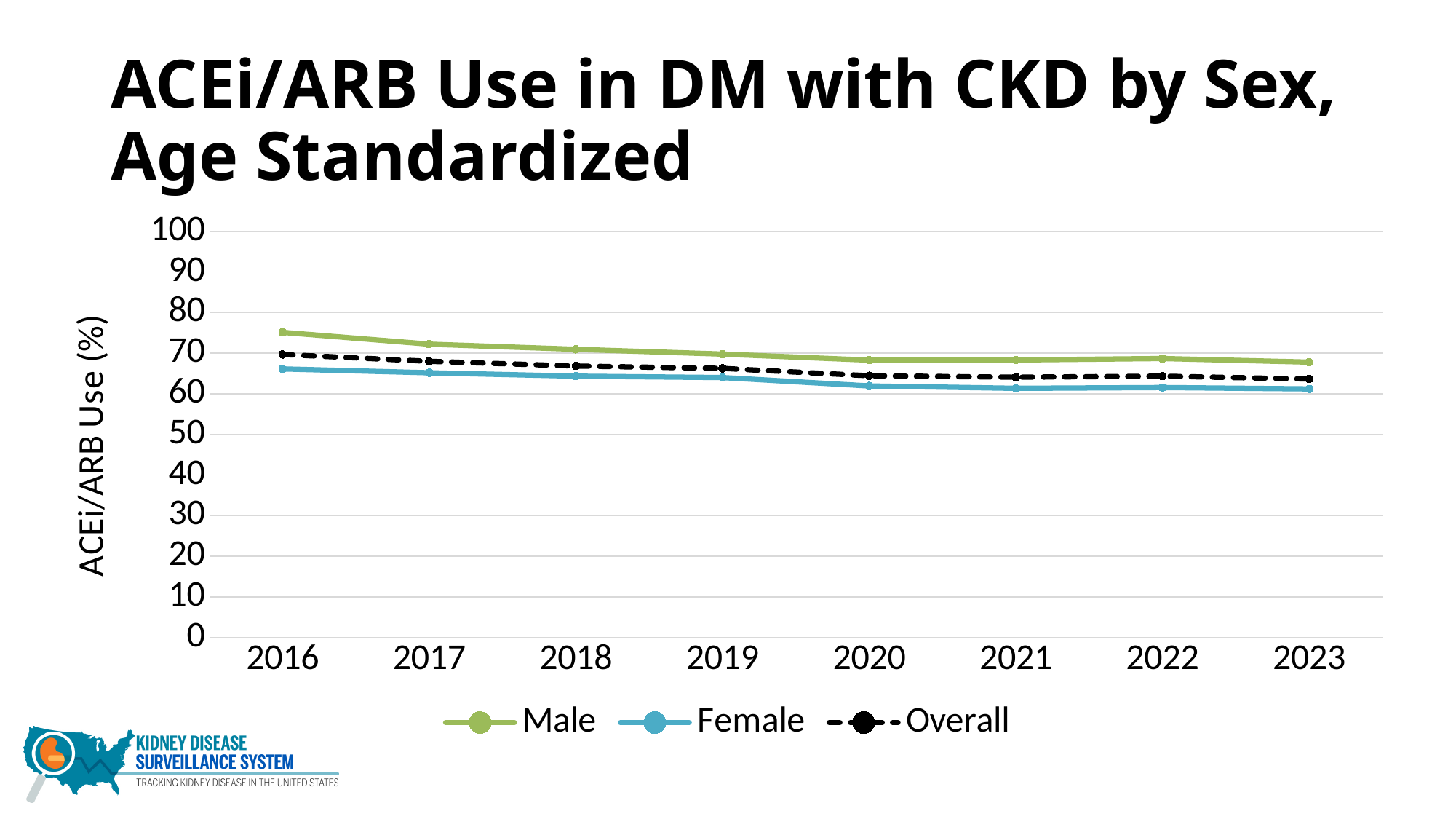
Is the value for Female in 2016 greater or less than 60? greater Is the value for Overall in 2016 greater or less than 80? less Does the Male series rise or fall from 2016 to 2023? Fall How many years are shown on the x axis? 8 Which series is drawn with a dashed line? Overall Which series has the lowest value in 2016? Female Is the value for Male in 2016 greater or less than 70? greater Which is larger in 2016, the value for Male or the value for Female? Male What type of chart is shown on the slide? Line chart Which series has the highest value in 2023? Male How many series does the legend list? 3